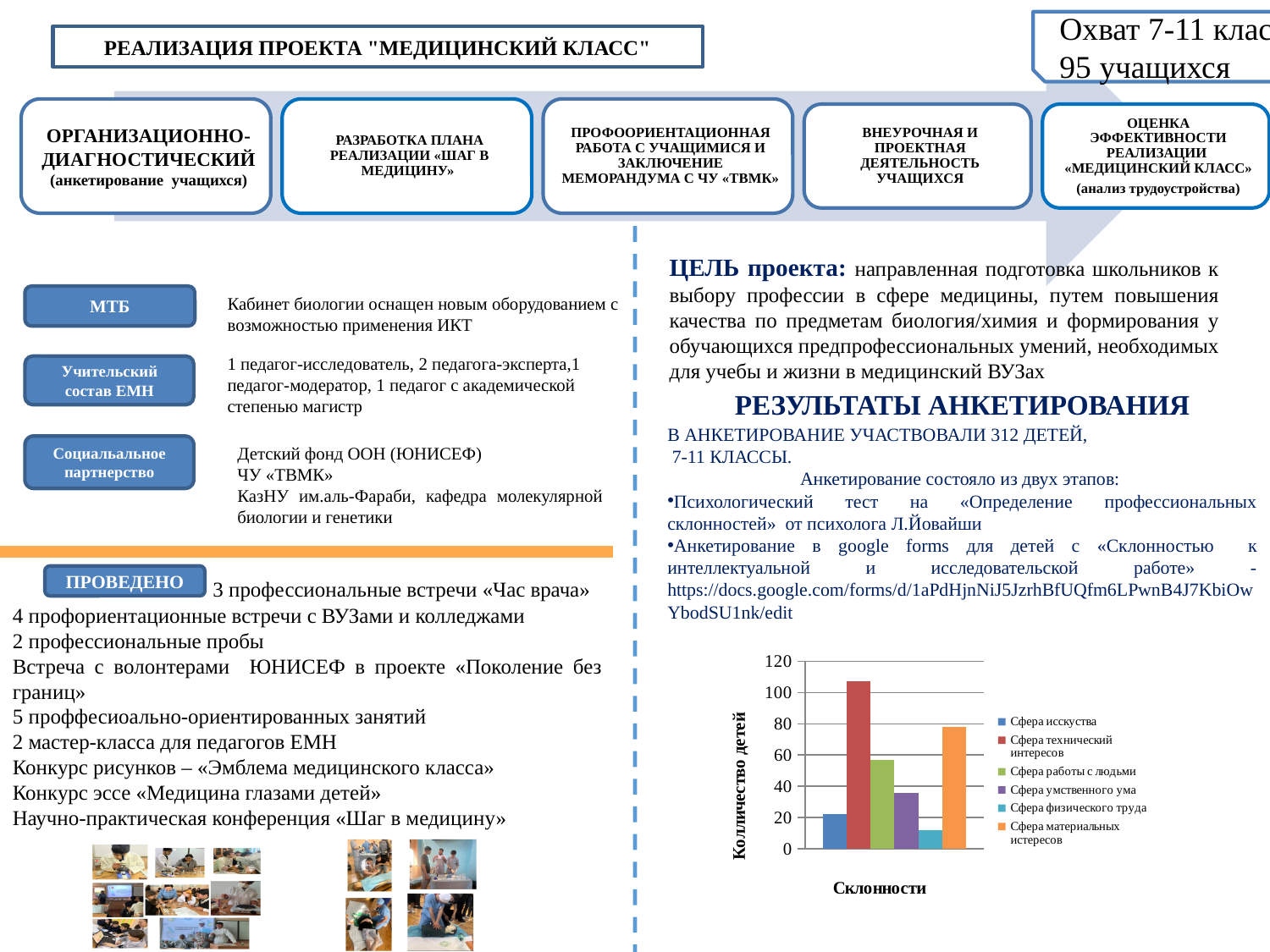
Which series has the lowest bar in the chart? Сфера физического труда What is the title of the vertical axis of the chart? Количество детей Is the value for Сфера физического труда greater or less than 20? less Is the value for Сфера исскуства greater or less than 40? less Which is larger, the value for Сфера работы с людьми or the value for Сфера умственного ума? Сфера работы с людьми Is the value for Сфера материальных истересов greater or less than 60? greater What is the title of the horizontal axis of the chart? Склонности What kind of chart is shown on the slide? bar chart How many series does the chart legend list? 6 Which series has the highest bar in the chart? Сфера технический интересов Which is larger, the value for Сфера материальных истересов or the value for Сфера исскуства? Сфера материальных истересов